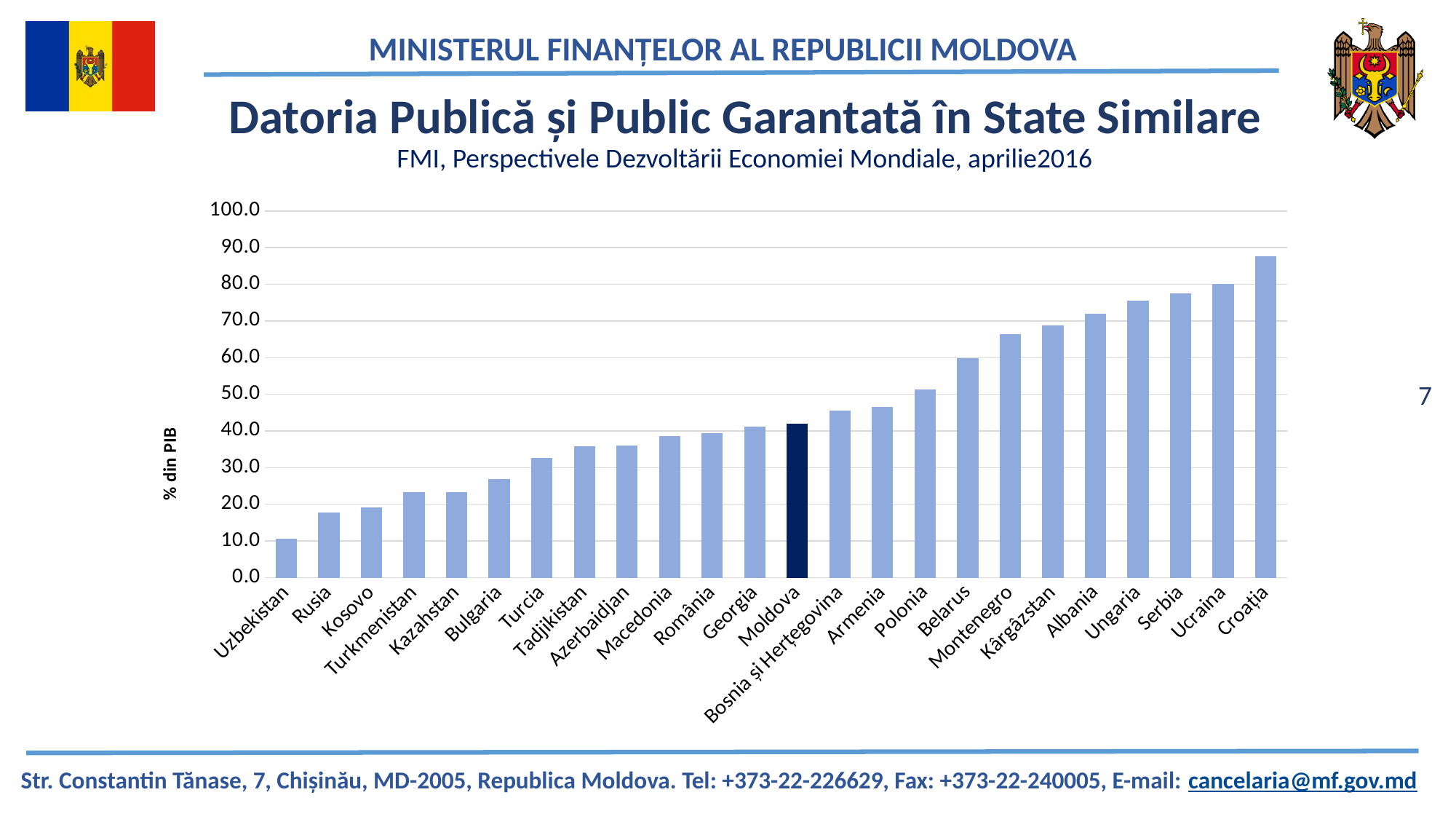
Is the value for Croația greater or less than 80? greater Which country has the highest public and publicly guaranteed debt as % of GDP? Croația Which country's bar is highlighted in dark blue? Moldova Which has a higher value, Moldova or Rusia? Moldova Which country has the lowest public and publicly guaranteed debt as % of GDP? Uzbekistan Do the values rise or fall from left to right along the x axis? rise How many countries are shown on the chart? 24 Is the value for Rusia greater or less than 20? less What kind of chart is shown on the slide? bar chart Is the value for Serbia greater or less than 80? less